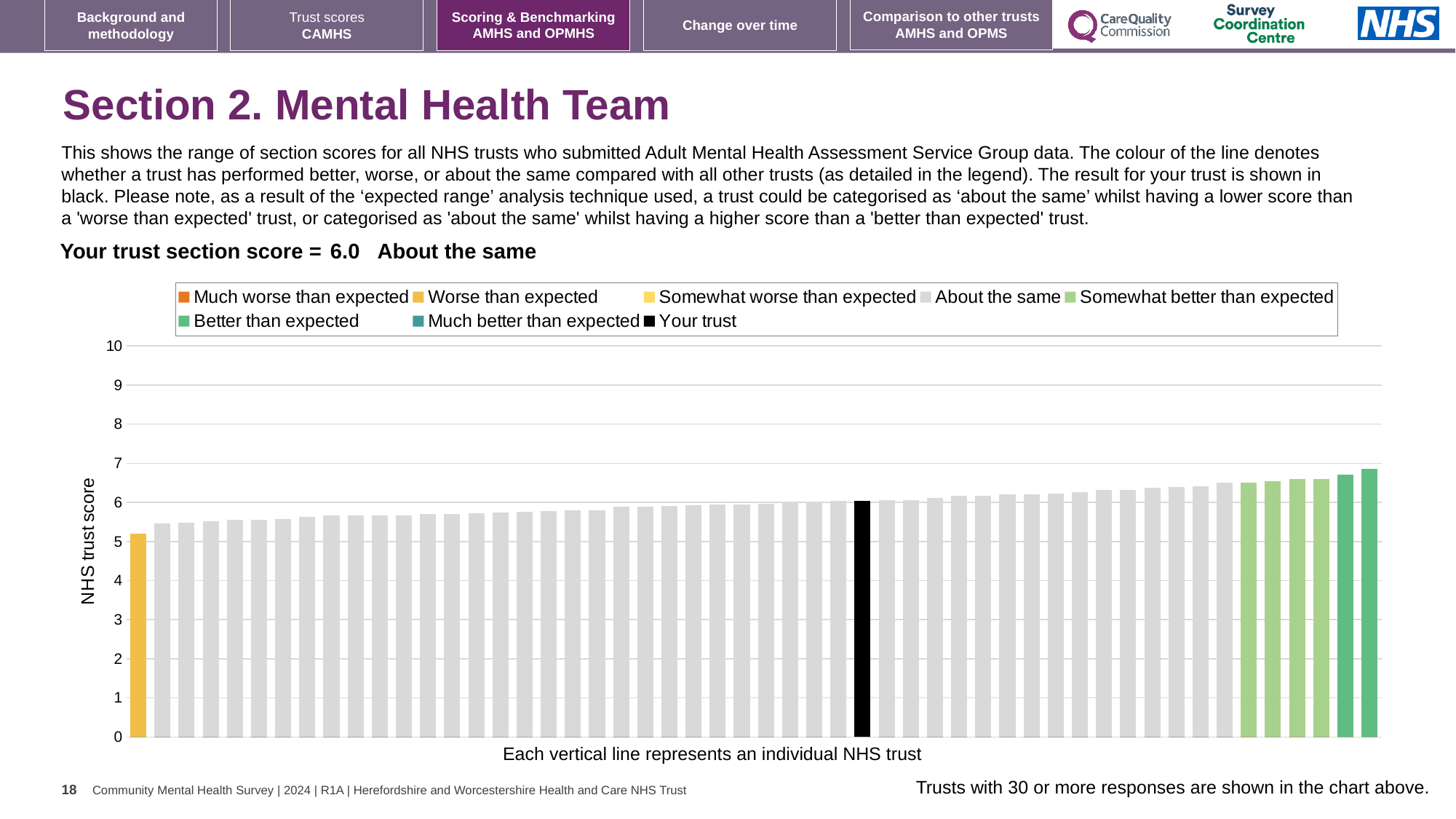
Which is larger, the leftmost bar or the rightmost bar? the rightmost bar Do the bar values rise or fall from left to right across the chart? rise Is the value for the leftmost (yellow) bar greater or less than 6? less What kind of chart is shown on the slide? Bar chart What is the section score for your trust (the black bar)? 6.0 What is the label on the vertical axis of the chart? NHS trust score Is the value for the rightmost bar greater or less than 6? greater How many entries does the chart legend list? 8 How many bars are coloured yellow (Worse than expected)? 1 Is the value for your trust (the black bar) greater or less than 7? less What is the highest value shown on the vertical axis? 10 Which category does your trust fall into according to the slide? About the same